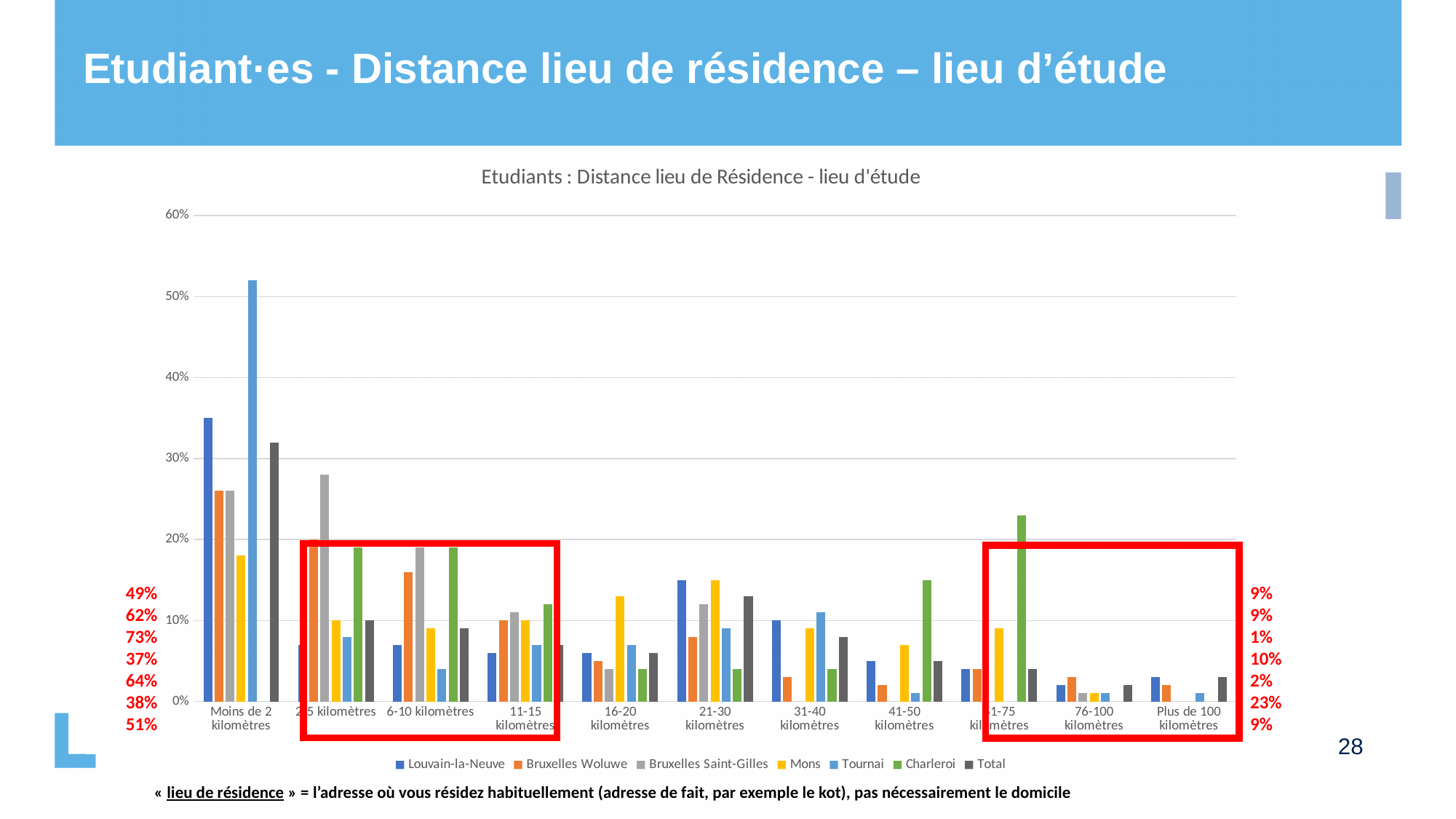
In the '16-20 kilomètres' category, which is larger: Mons or Tournai? Mons Is the value for Charleroi in the '51-75 kilomètres' category greater or less than 20%? greater What is the title of the chart? Etudiants : Distance lieu de Résidence - lieu d'étude What kind of chart is shown on the slide? bar chart Is the value for Tournai in the 'Moins de 2 kilomètres' category greater or less than 50%? greater Is the value for Louvain-la-Neuve in the 'Moins de 2 kilomètres' category greater or less than 30%? greater Which series has the highest value in the 'Moins de 2 kilomètres' category? Tournai How many series does the chart legend list? 7 How many distance categories are shown on the x axis? 11 In which category does Charleroi reach its highest value? 51-75 kilomètres In the 'Moins de 2 kilomètres' category, which is larger: Louvain-la-Neuve or Tournai? Tournai